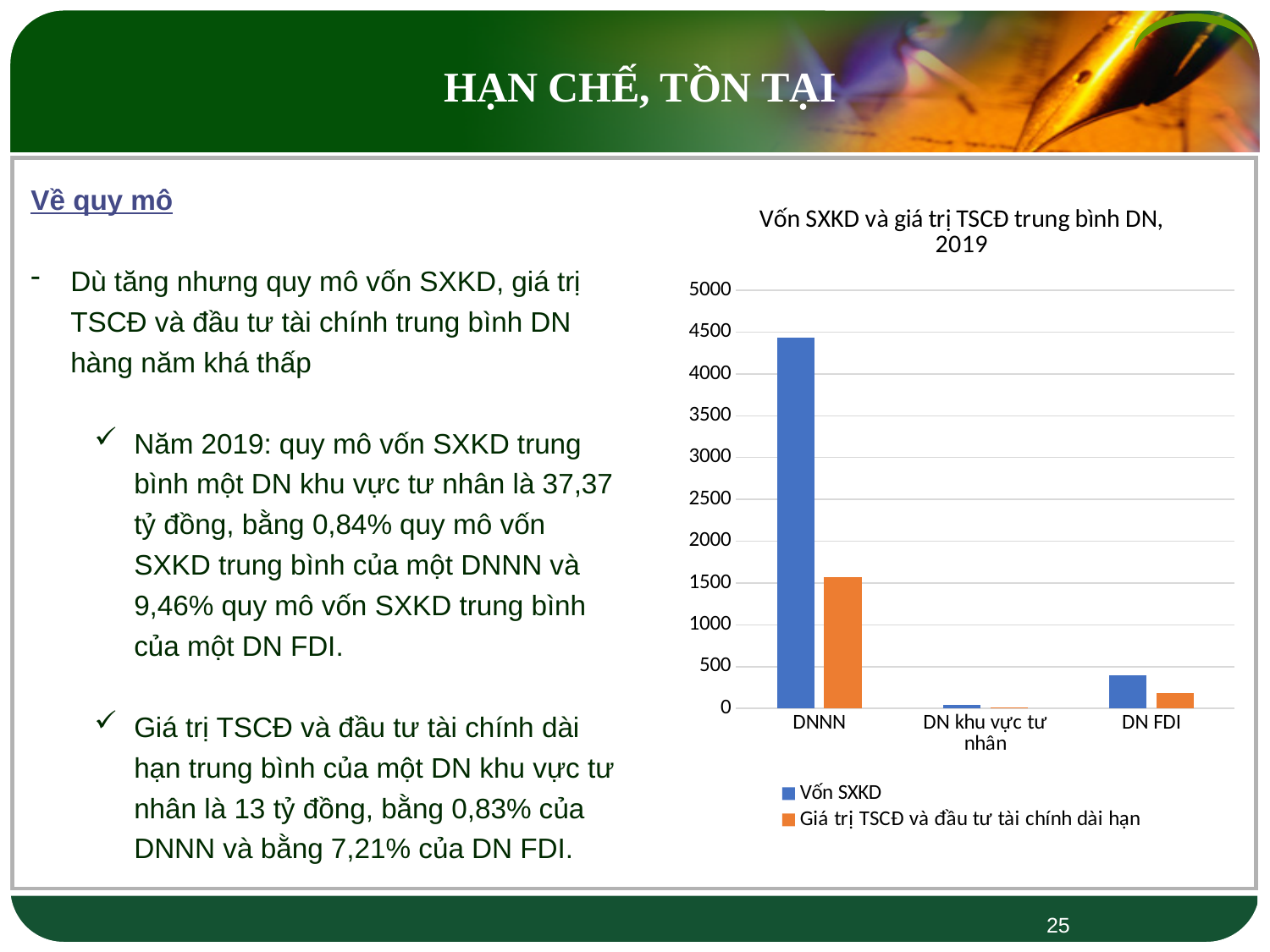
Is the value of Vốn SXKD for DNNN greater or less than 4000? greater Is the value of Giá trị TSCĐ và đầu tư tài chính dài hạn for DNNN greater or less than 2000? less Which category has the highest value for Vốn SXKD? DNNN Which category has the lowest value for Vốn SXKD? DN khu vực tư nhân How many series does the chart legend list? 2 What kind of chart is shown on the slide? bar chart Which colour represents the Vốn SXKD series in the chart? blue How many categories are shown on the x axis of the chart? 3 Which category has the highest value for Giá trị TSCĐ và đầu tư tài chính dài hạn? DNNN What is the title of the chart? Vốn SXKD và giá trị TSCĐ trung bình DN, 2019 For DNNN, which is larger: Vốn SXKD or Giá trị TSCĐ và đầu tư tài chính dài hạn? Vốn SXKD Is the value of Vốn SXKD for DN FDI greater or less than 500? less